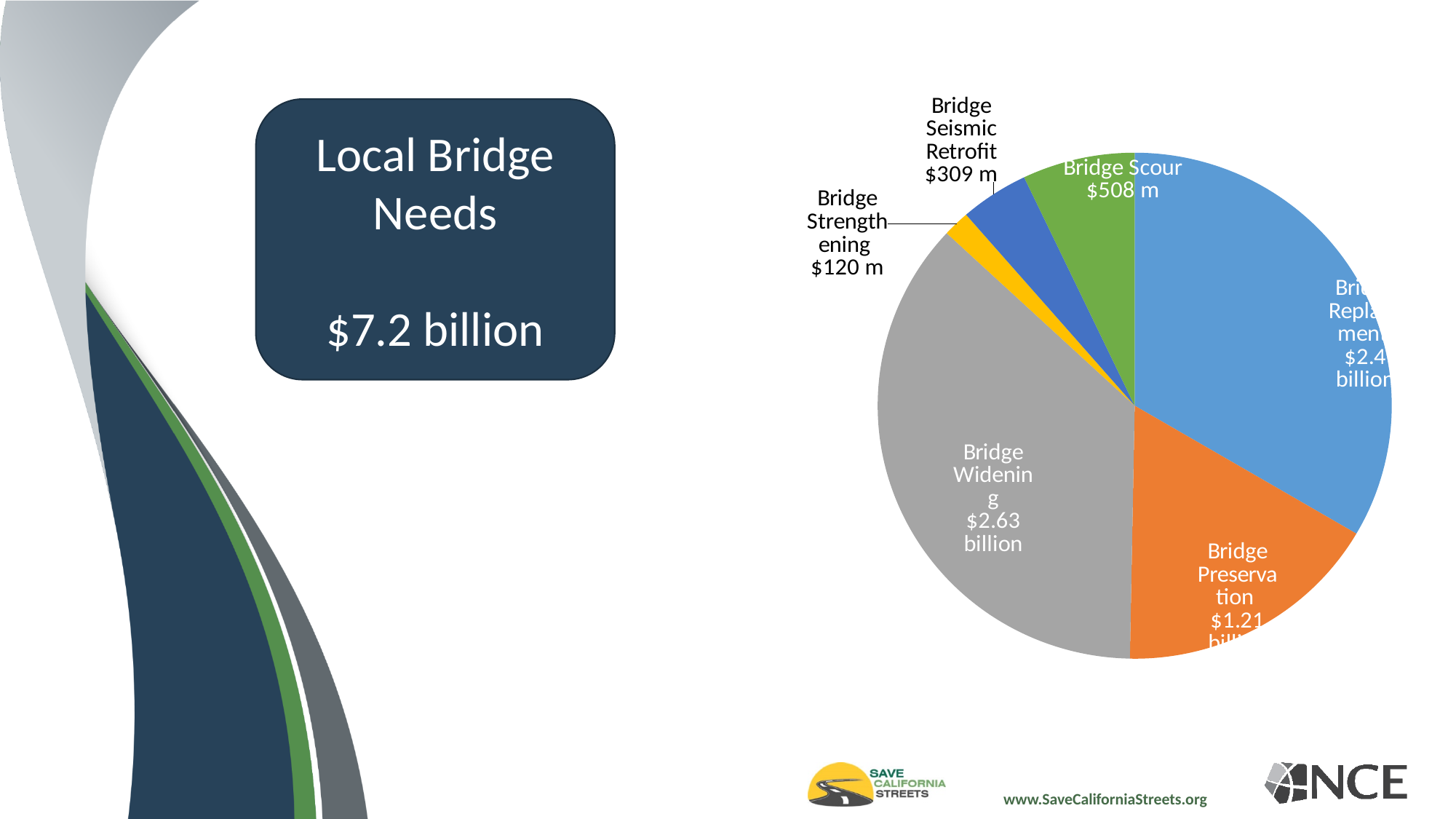
How many slices does the pie chart have? 6 What is the difference between the Bridge Seismic Retrofit and Bridge Strengthening values? $189 m What is the value shown for Bridge Seismic Retrofit? $309 m What kind of chart is shown on the slide? pie chart What is the value shown for Bridge Strengthening? $120 m Which category has the smallest slice of the pie? Bridge Strengthening What is the difference between the Bridge Scour and Bridge Seismic Retrofit values? $199 m What is the value shown for Bridge Scour? $508 m Which is larger, Bridge Scour or Bridge Seismic Retrofit? Bridge Scour What total amount for Local Bridge Needs is shown in the box on the slide? $7.2 billion What is the value shown for Bridge Widening? $2.63 billion Which category has the largest slice of the pie? Bridge Widening